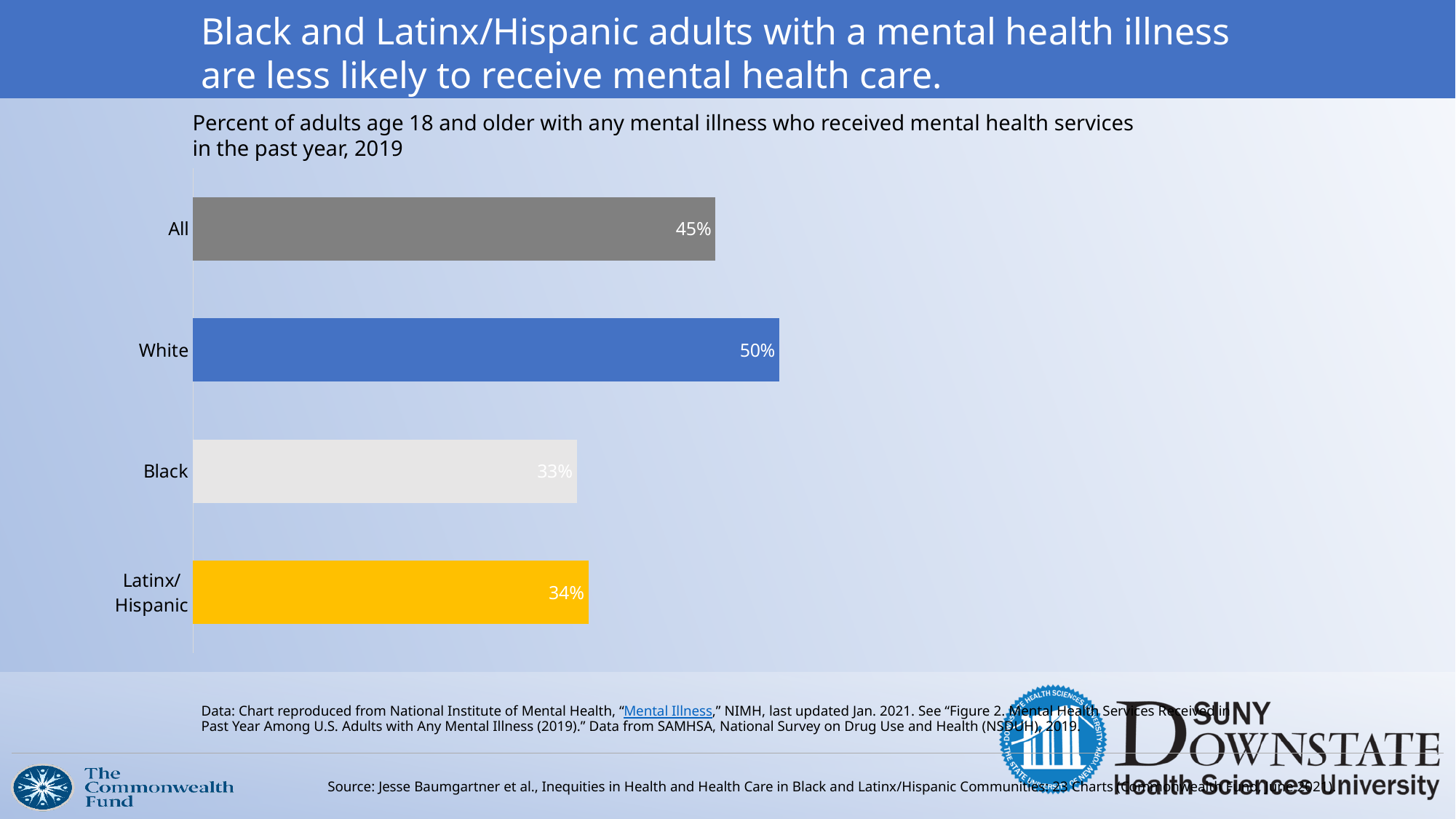
What is the difference between the values for White and Black adults? 17% What is the value shown for the All category? 45% What kind of chart is shown on the slide? Bar chart What is the value shown for Black adults? 33% How many categories are shown in the chart? 4 Which category has the lowest value? Black Which category has the highest value? White What percent of White adults with any mental illness received mental health services? 50% What colour is the bar for Latinx/Hispanic adults? Yellow Which is larger, the value for White adults or the value for All adults? White What is the value shown for Latinx/Hispanic adults? 34% What is the difference between the values for All and Latinx/Hispanic adults? 11%